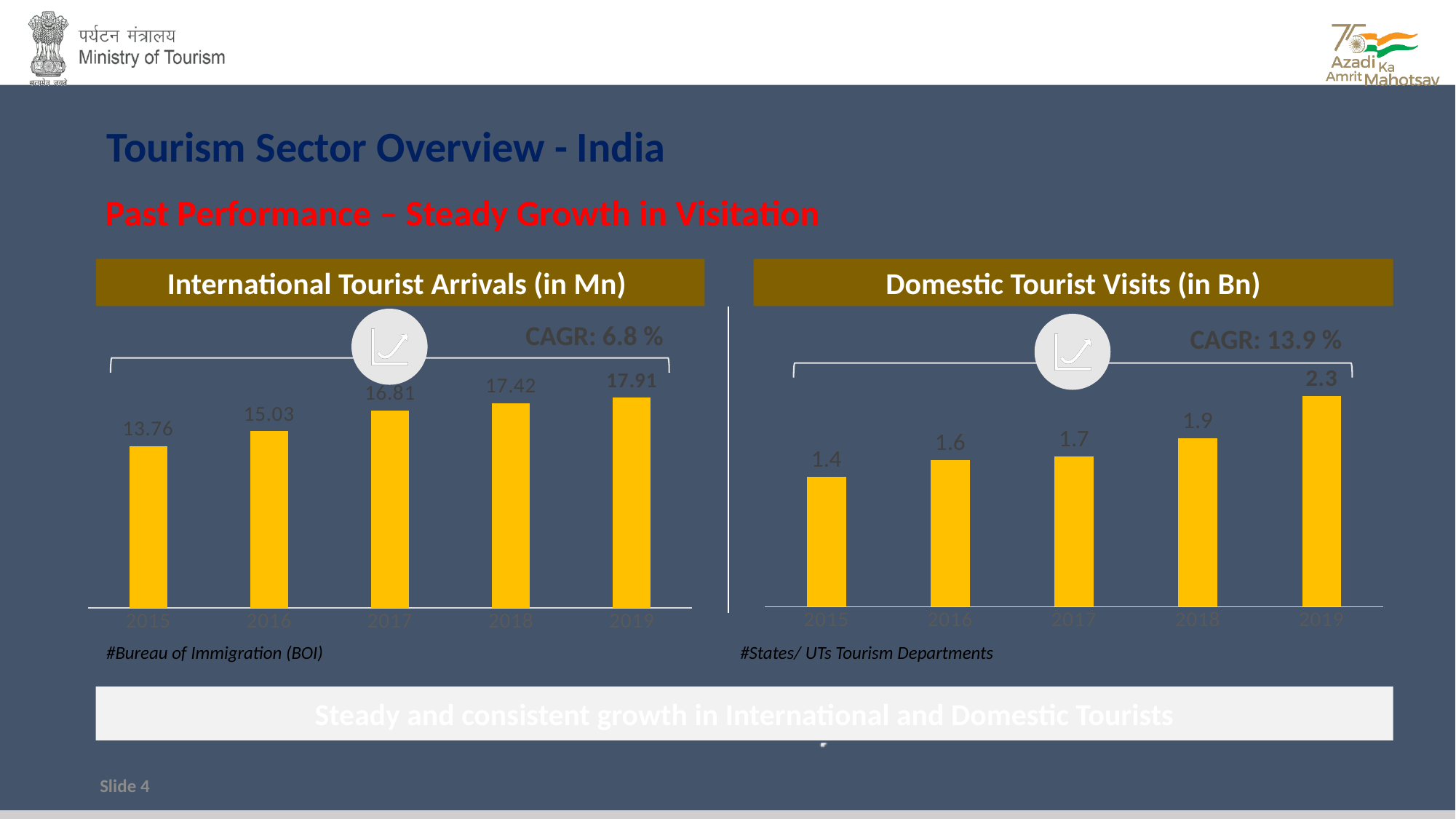
What kind of chart is the Domestic Tourist Visits (in Bn) chart? bar chart In the International Tourist Arrivals (in Mn) chart, what is the difference between the 2019 and 2015 values? 4.15 In the Domestic Tourist Visits (in Bn) chart, what is the value for 2015? 1.4 In the International Tourist Arrivals (in Mn) chart, how many years are plotted? 5 In the Domestic Tourist Visits (in Bn) chart, what is the value for 2018? 1.9 In the International Tourist Arrivals (in Mn) chart, do the values rise or fall from 2015 to 2019? rise In the Domestic Tourist Visits (in Bn) chart, what is the difference between the 2019 and 2017 values? 0.6 In the International Tourist Arrivals (in Mn) chart, which year has the highest value? 2019 What CAGR is shown on the Domestic Tourist Visits (in Bn) chart? 13.9 % In the Domestic Tourist Visits (in Bn) chart, which year has the highest value? 2019 In the International Tourist Arrivals (in Mn) chart, what is the value for 2017? 16.81 In the International Tourist Arrivals (in Mn) chart, which year has the lowest value? 2015